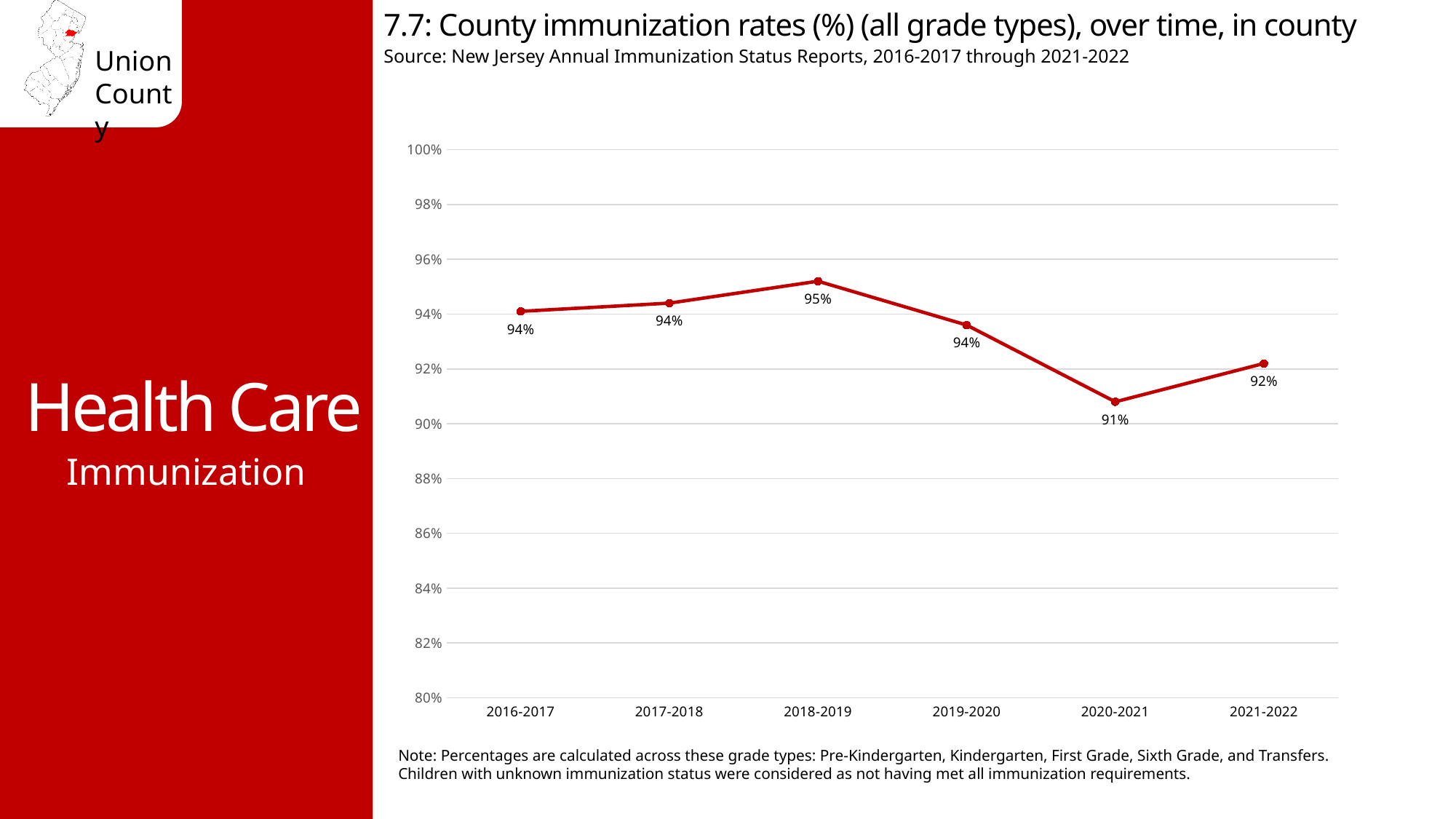
Which is larger, the immunization rate in 2019-2020 or in 2021-2022? 2019-2020 What is the county immunization rate for 2016-2017? 94% What is the county immunization rate for 2018-2019? 95% What is the difference between the immunization rate in 2018-2019 and in 2020-2021, using the printed labels? 4% Is the immunization rate for 2020-2021 greater or less than 92%? less Which school year has the lowest immunization rate? 2020-2021 Does the immunization rate rise or fall from 2018-2019 to 2020-2021? fall What is the county immunization rate for 2021-2022? 92% What kind of chart is shown on the slide? line chart How many school years are plotted on the chart? 6 Which school year has the highest immunization rate? 2018-2019 What is the county immunization rate for 2020-2021? 91%